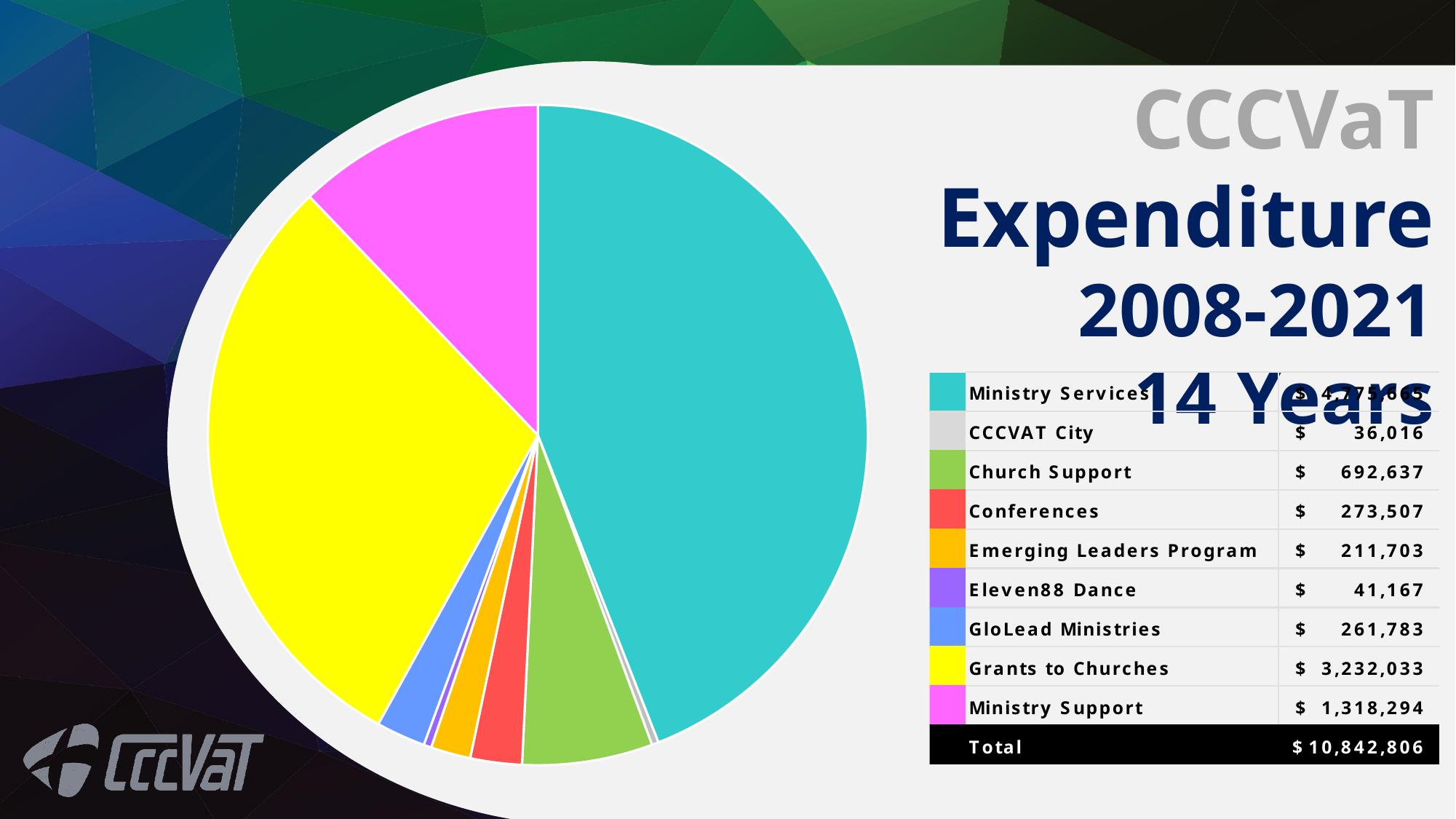
What type of chart is shown on the slide? pie chart What is the difference between the expenditure for Grants to Churches and Ministry Support? $ 1,913,739 What is the expenditure value for Emerging Leaders Program? $ 211,703 What is the expenditure value for Grants to Churches? $ 3,232,033 What is the expenditure value for Church Support? $ 692,637 How many expenditure categories are shown in the pie chart? 9 Which category has the largest expenditure? Ministry Services What is the total expenditure shown on the slide? $ 10,842,806 What is the expenditure value for Ministry Support? $ 1,318,294 Which has the larger expenditure, Conferences or GloLead Ministries? Conferences What colour represents Grants to Churches in the pie chart? yellow Which category has the smallest expenditure? CCCVAT City